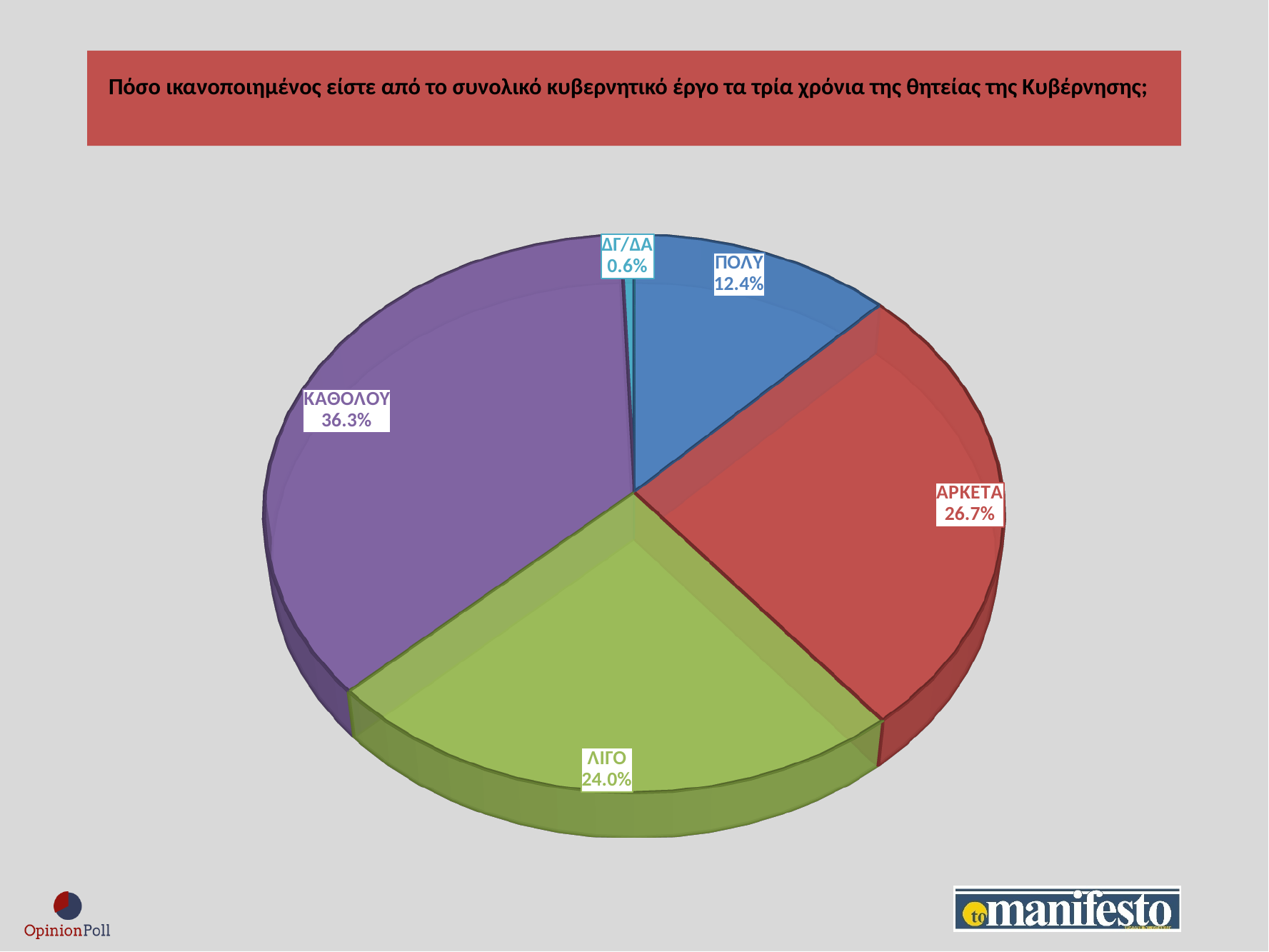
How many slices does the pie chart have? 5 What percentage of the pie is labelled ΠΟΛΥ? 12.4% What kind of chart is shown on the slide? Pie chart Which is larger, the share for ΑΡΚΕΤΑ or the share for ΛΙΓΟ? ΑΡΚΕΤΑ What colour is the ΛΙΓΟ slice? Green What percentage of the pie is labelled ΚΑΘΟΛΟΥ? 36.3% What is the difference in percentage points between ΚΑΘΟΛΟΥ and ΑΡΚΕΤΑ? 9.6 What percentage of the pie is labelled ΔΓ/ΔΑ? 0.6% Which category has the largest share of the pie? ΚΑΘΟΛΟΥ What percentage of the pie is labelled ΛΙΓΟ? 24.0% What percentage of the pie is labelled ΑΡΚΕΤΑ? 26.7% Which category has the smallest share of the pie? ΔΓ/ΔΑ